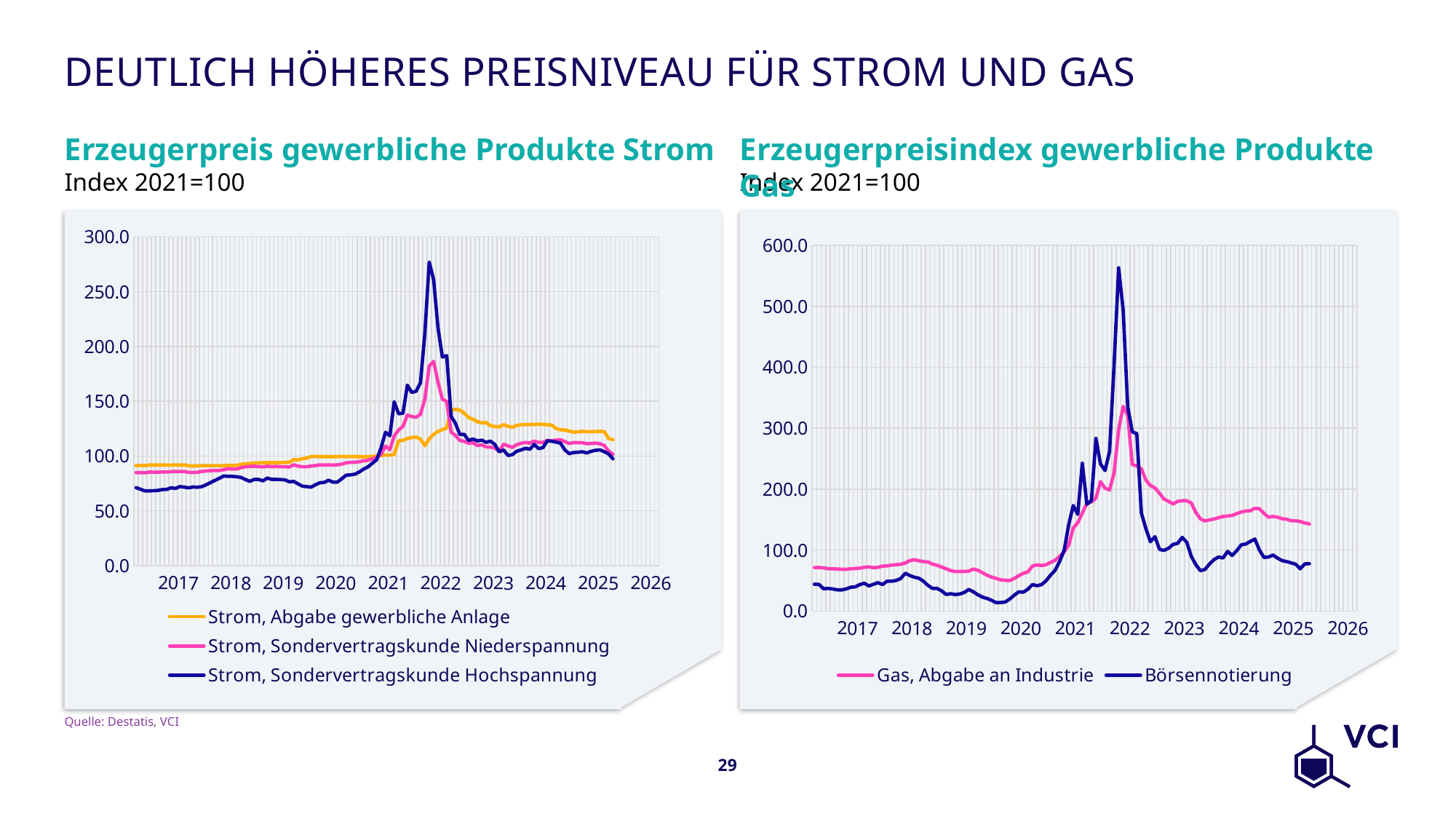
How many series does the legend of the right chart, 'Erzeugerpreisindex gewerbliche Produkte Gas', list? 2 What source is cited for the charts on the slide? Destatis, VCI In the left chart, 'Erzeugerpreis gewerbliche Produkte Strom', which series reaches the highest peak? Strom, Sondervertragskunde Hochspannung In the left chart, 'Erzeugerpreis gewerbliche Produkte Strom', is the peak value of Strom, Sondervertragskunde Niederspannung greater or less than 200? less In the right chart, 'Erzeugerpreisindex gewerbliche Produkte Gas', does the Gas, Abgabe an Industrie series rise or fall between 2022 and 2025? fall How many series does the legend of the left chart, 'Erzeugerpreis gewerbliche Produkte Strom', list? 3 What base year is used for the index in both charts? 2021=100 In the right chart, 'Erzeugerpreisindex gewerbliche Produkte Gas', is the peak value of Börsennotierung greater or less than 500? greater In the right chart, 'Erzeugerpreisindex gewerbliche Produkte Gas', which series reaches the highest peak? Börsennotierung What kind of chart is the left chart, 'Erzeugerpreis gewerbliche Produkte Strom'? line chart In the left chart, 'Erzeugerpreis gewerbliche Produkte Strom', is the peak value of Strom, Sondervertragskunde Hochspannung greater or less than 250? greater